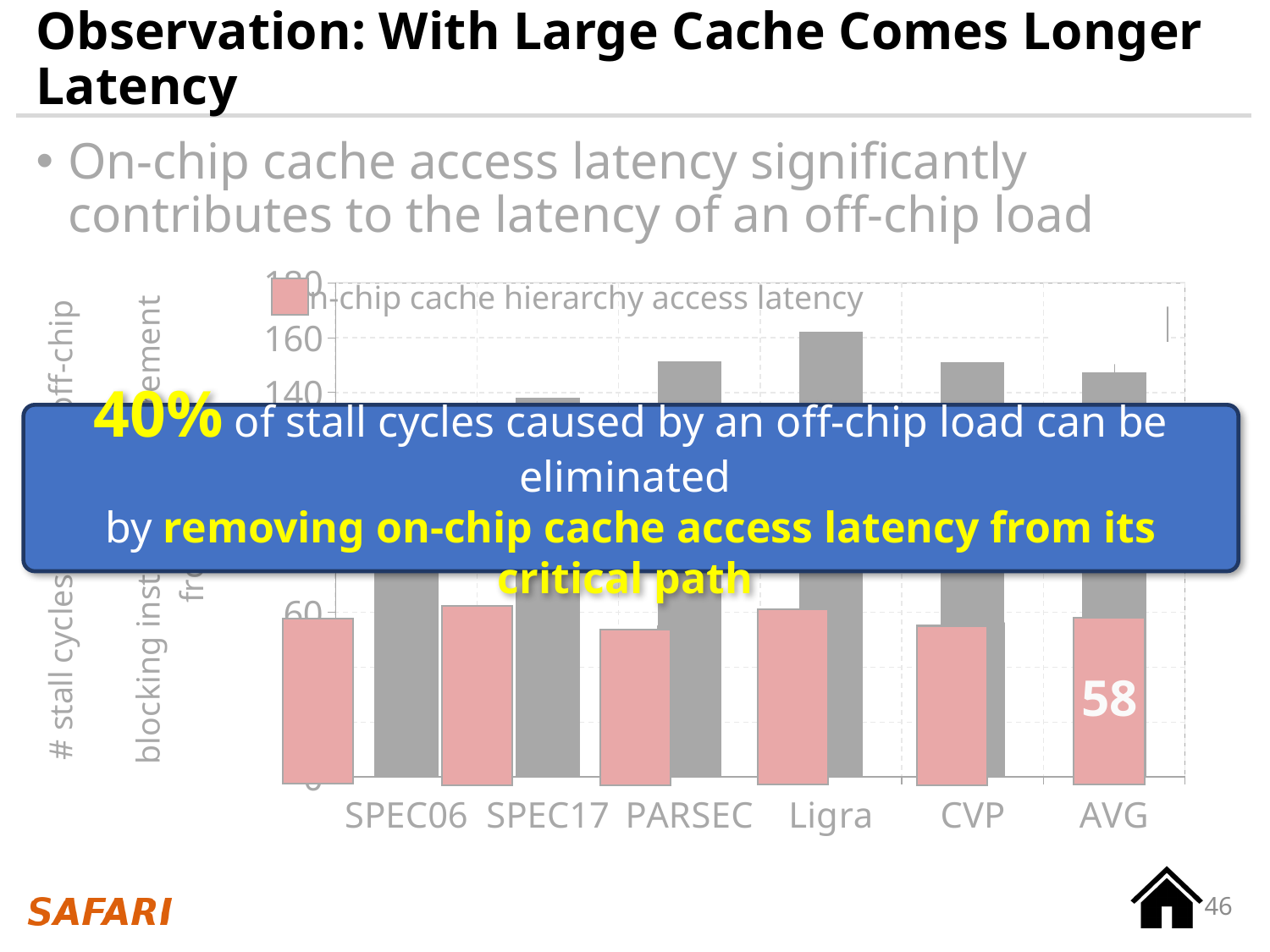
How many categories are shown along the x axis of the chart? 6 Is the on-chip cache hierarchy access latency bar for PARSEC greater or less than 60? less Which has the taller on-chip cache hierarchy access latency bar, SPEC17 or PARSEC? SPEC17 Which category has the tallest gray bar? Ligra What colour are the bars for on-chip cache hierarchy access latency in the legend? pink What is the labelled value of the on-chip cache hierarchy access latency bar for AVG? 58 What kind of chart is shown on the slide? bar chart Is the on-chip cache hierarchy access latency bar for CVP greater or less than 60? less What is the last category on the x axis of the chart? AVG Which has the taller gray bar, Ligra or CVP? Ligra